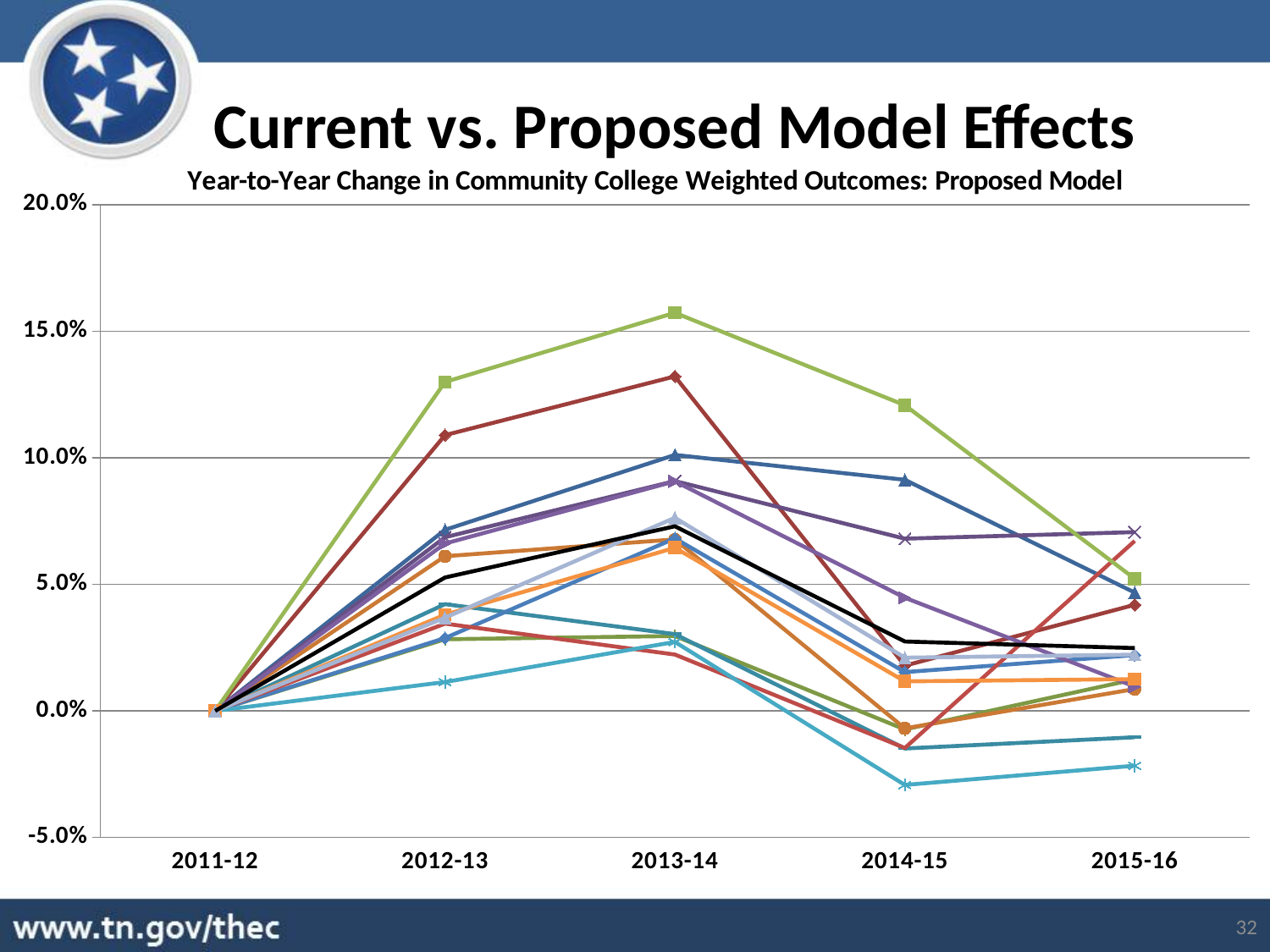
What value do all the lines share in 2011-12? 0.0% What is the title of the chart? Year-to-Year Change in Community College Weighted Outcomes: Proposed Model Does the topmost line rise or fall from 2013-14 to 2014-15? fall Is the highest plotted value in 2015-16 greater or less than 10.0%? less What kind of chart is shown on the slide? line chart What is the maximum value shown on the y axis of the chart? 20.0% Is the highest plotted value in 2012-13 greater or less than 10.0%? greater Is the lowest plotted value in 2014-15 greater or less than 0.0%? less How many academic years are shown on the x axis of the chart? 5 In which year does the chart reach its highest plotted value? 2013-14